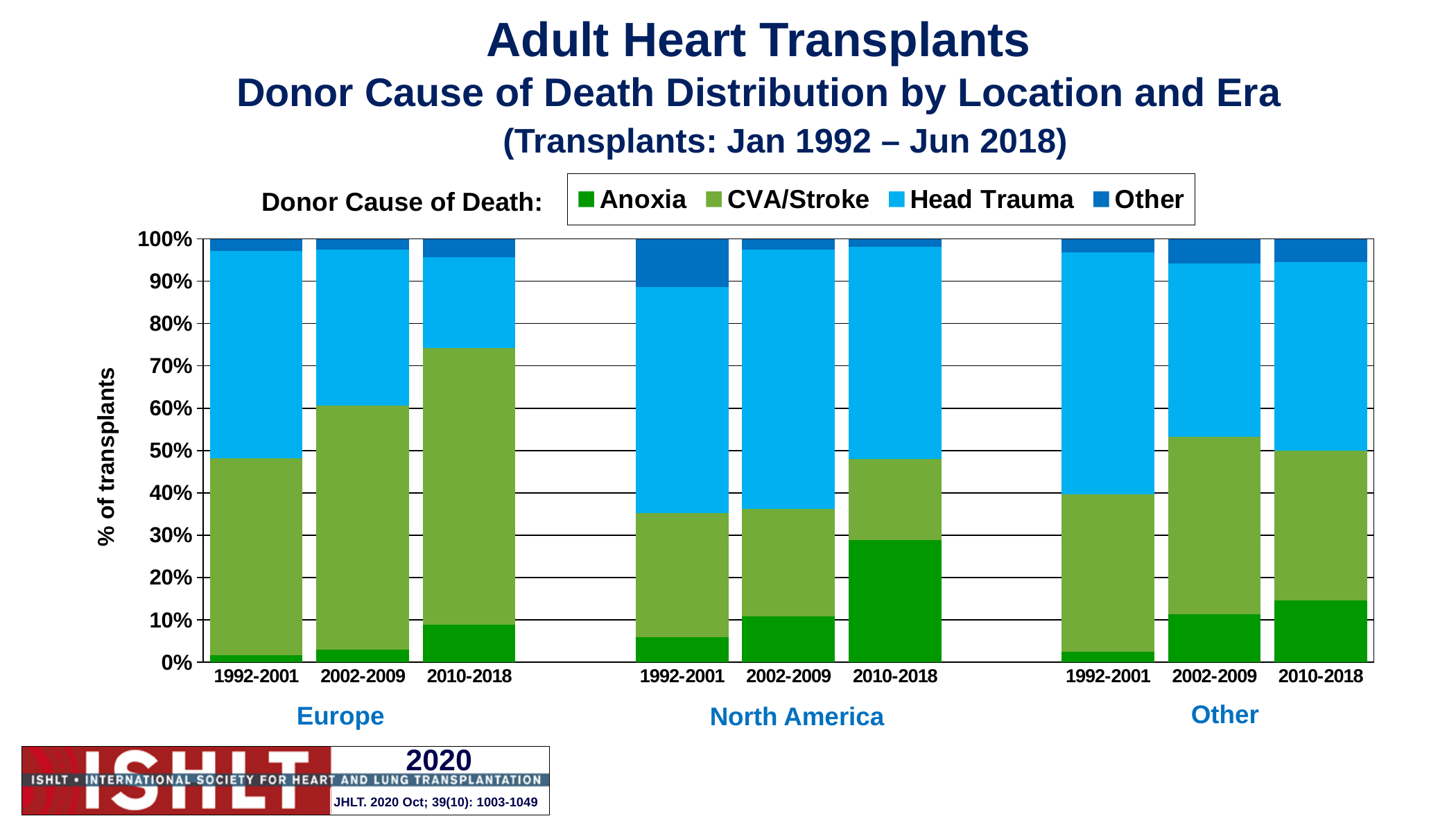
Does the Anoxia share in North America rise or fall from 1992-2001 to 2010-2018? rise How many stacked bars are plotted in the chart? 9 What is the label on the y axis? % of transplants What kind of chart is shown on the slide? Stacked bar chart Does the CVA/Stroke share in Europe rise or fall from 1992-2001 to 2010-2018? rise Is the Anoxia share for Europe 1992-2001 greater or less than 10%? less Is the Anoxia share for North America 2010-2018 greater or less than 20%? greater How many location groups are shown along the x axis? 3 Which bar has the largest Other segment? North America 1992-2001 How many donor cause of death series does the legend list? 4 Is the Anoxia share for Other 2010-2018 greater or less than 10%? greater Which bar has the largest Anoxia segment? North America 2010-2018